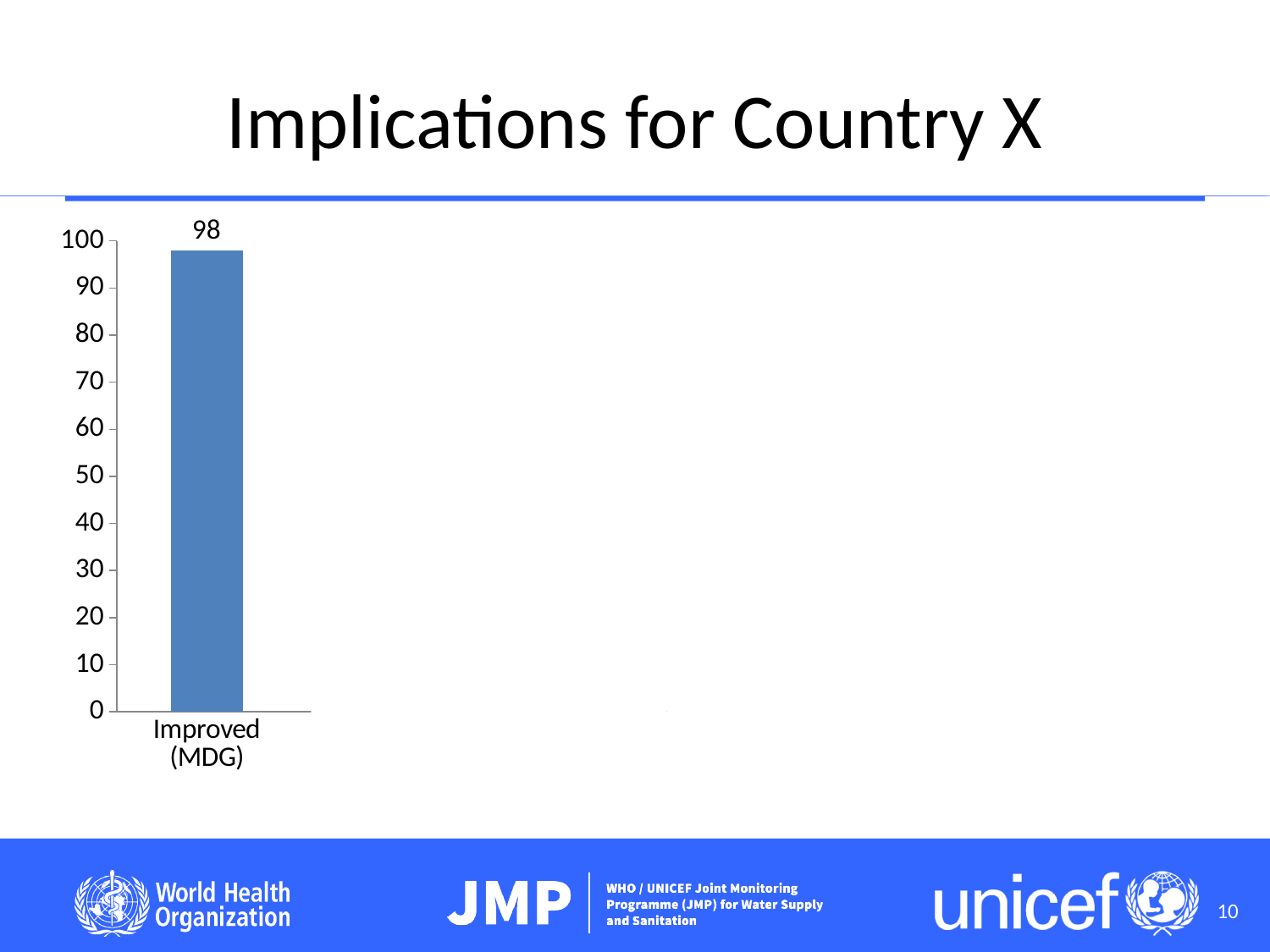
Is the value for Improved (MDG) greater or less than 100? less What is the label of the category on the x axis? Improved (MDG) Is the value for Improved (MDG) greater or less than 90? greater What is the value for Improved (MDG)? 98 What is the title of the slide containing the chart? Implications for Country X How many bars are plotted in the chart? 1 What is the highest value shown on the vertical axis? 100 What kind of chart is shown on the slide? bar chart